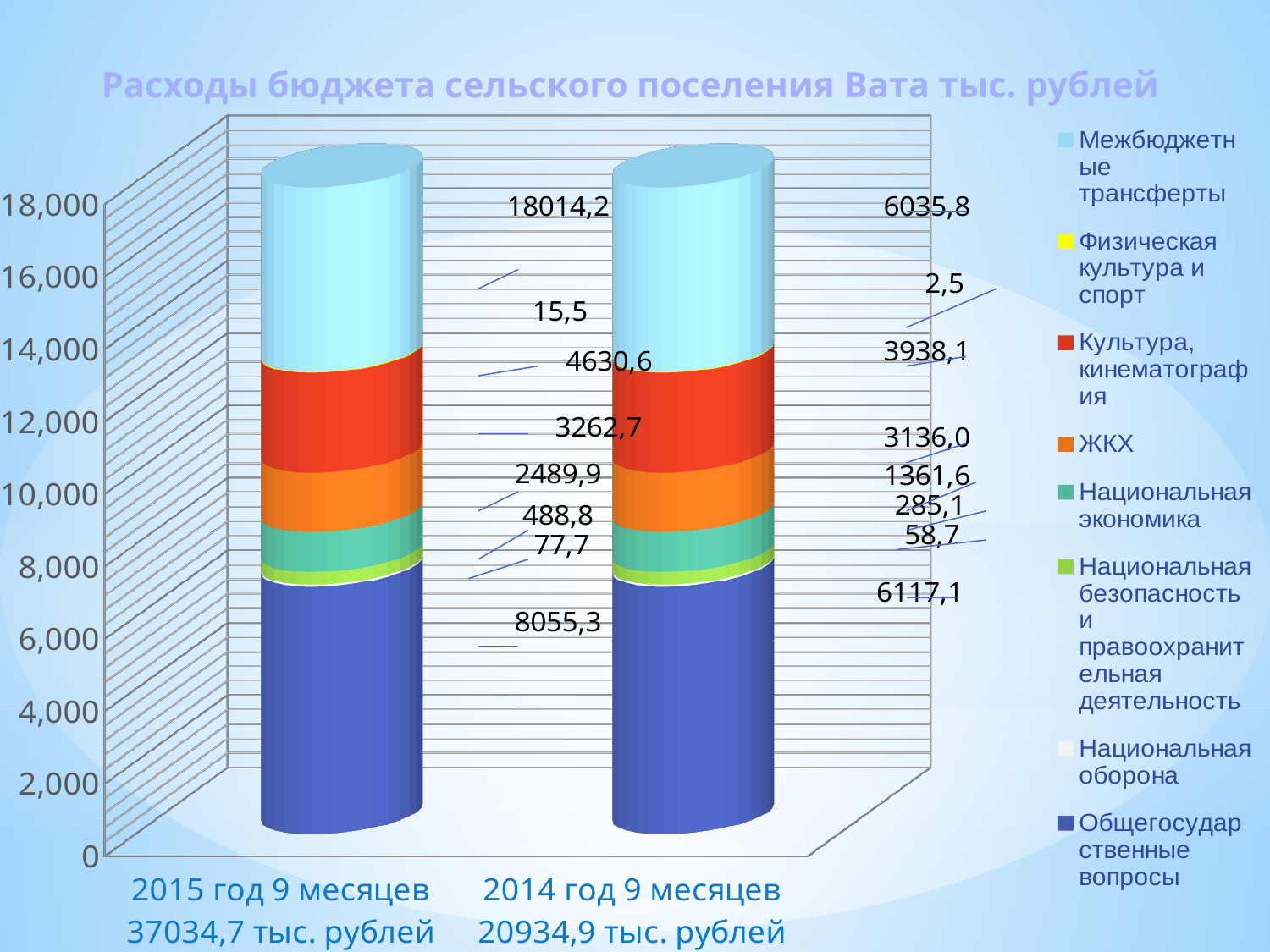
Which is larger: Общегосударственные вопросы in 2015 год 9 месяцев or in 2014 год 9 месяцев? 2015 год 9 месяцев Which series has the largest value in the 2015 год 9 месяцев bar? Межбюджетные трансферты What is the value for ЖКХ in 2015 год 9 месяцев? 3262,7 What kind of chart is shown on the slide? Stacked bar chart What is the total of the stacked bar for 2015 год 9 месяцев? 37034,7 тыс. рублей Which series has the smallest value in the 2014 год 9 месяцев bar? Физическая культура и спорт What is the value for Физическая культура и спорт in 2014 год 9 месяцев? 2,5 How many series does the legend list? 8 By how much does Межбюджетные трансферты in 2015 год 9 месяцев exceed the same series in 2014 год 9 месяцев? 11978,4 What is the value for Культура, кинематография in 2014 год 9 месяцев? 3938,1 What is the value for Межбюджетные трансферты in 2015 год 9 месяцев? 18014,2 What is the value for Общегосударственные вопросы in 2014 год 9 месяцев? 6117,1